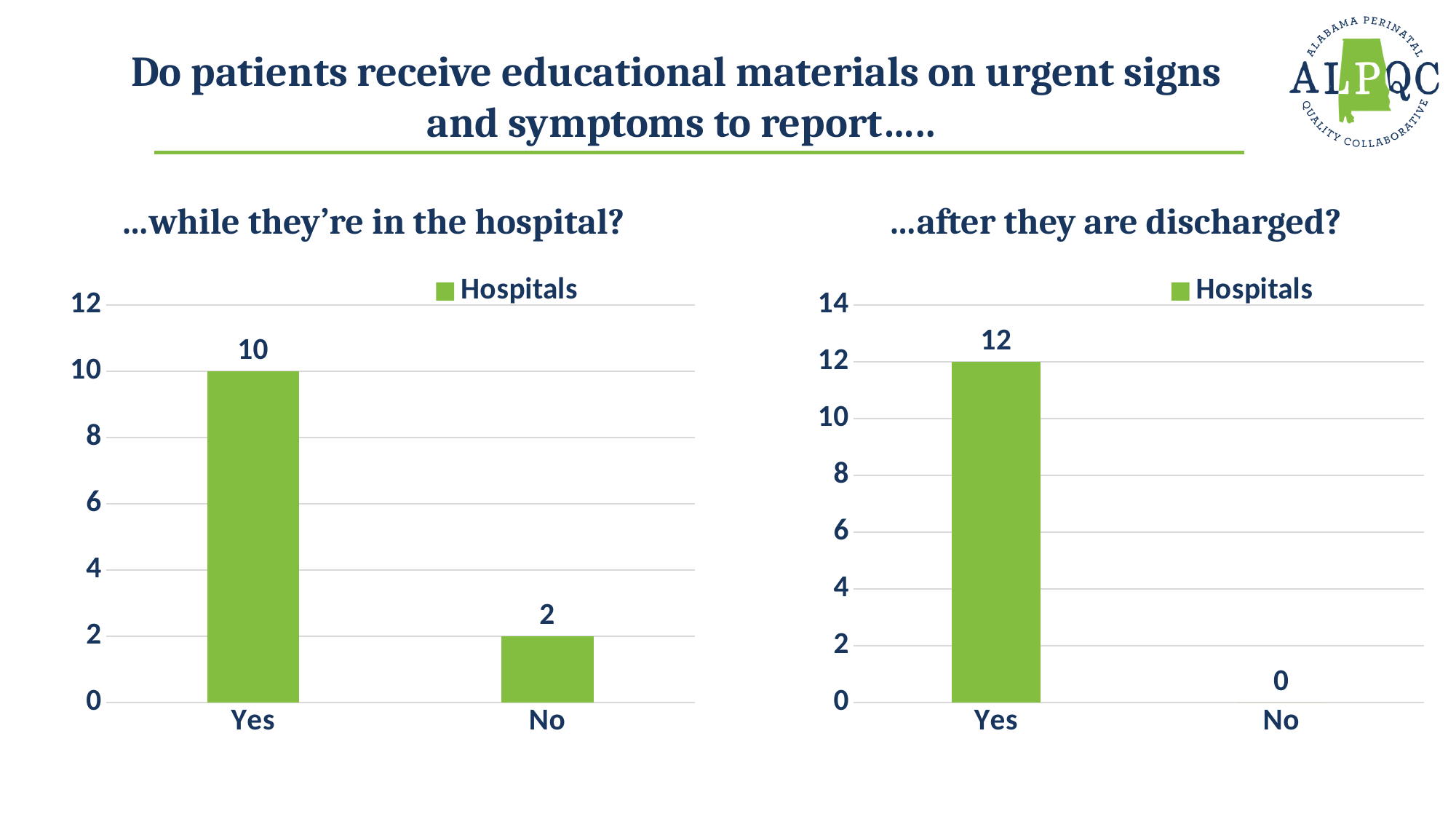
What series name does the legend of the left chart ("...while they're in the hospital?") show? Hospitals In the left chart ("...while they're in the hospital?"), which category has the highest value? Yes In the right chart ("...after they are discharged?"), what is the value for Yes? 12 In the right chart ("...after they are discharged?"), which category has the lowest value? No In the left chart ("...while they're in the hospital?"), what is the value for Yes? 10 How many categories are shown in the left chart ("...while they're in the hospital?")? 2 In the right chart ("...after they are discharged?"), what is the value for No? 0 Which is larger: the Yes value in the left chart or the Yes value in the right chart? The Yes value in the right chart In the right chart ("...after they are discharged?"), what is the difference between the Yes and No values? 12 In the left chart ("...while they're in the hospital?"), what is the difference between the Yes and No values? 8 In the left chart ("...while they're in the hospital?"), what is the value for No? 2 What type of chart is the right chart ("...after they are discharged?")? Bar chart